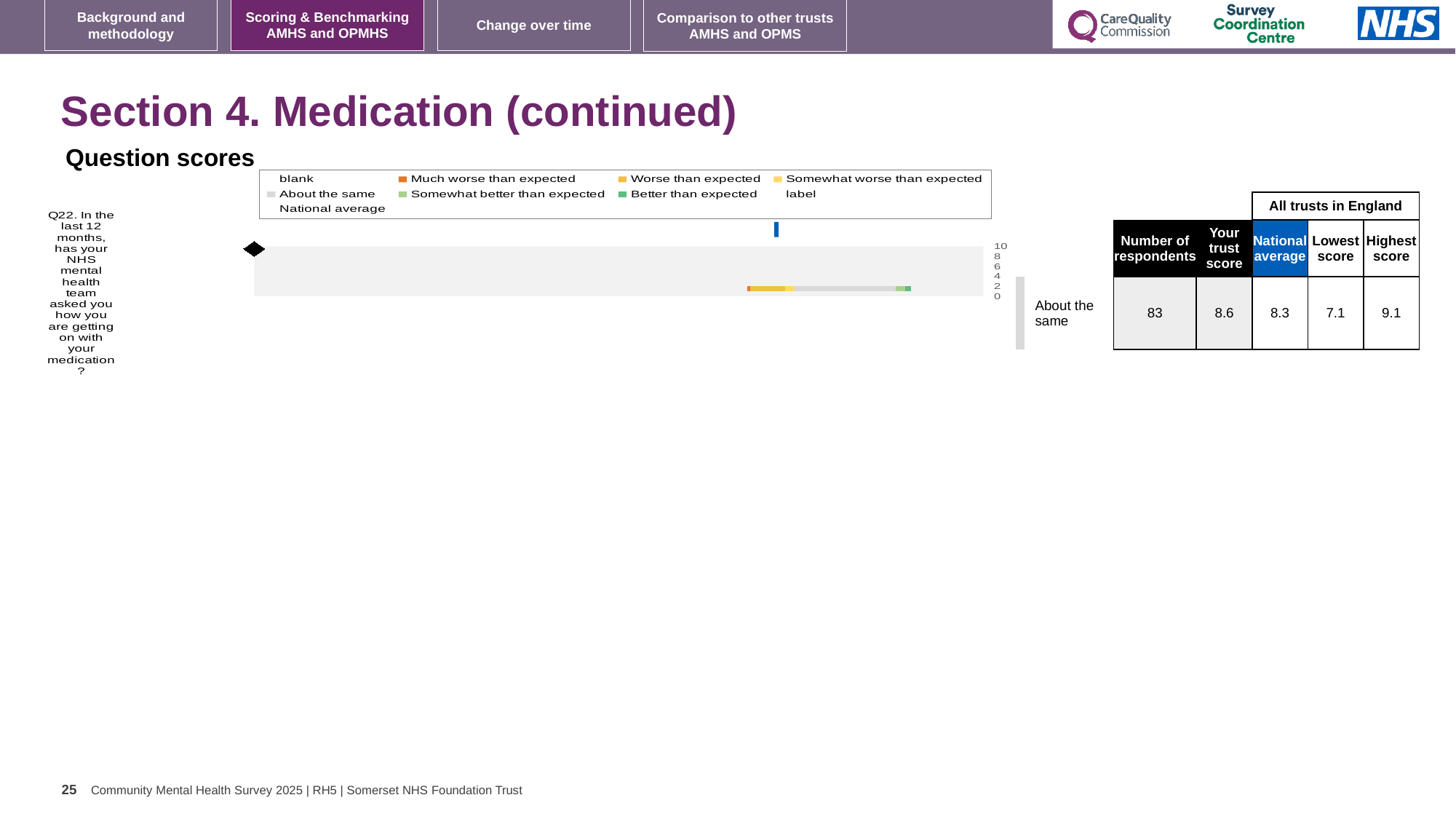
Which question number is plotted in the question scores chart? Q22 Is your trust score for Q22 higher or lower than the national average? Higher In the table beside the chart, what is the national average for Q22? 8.3 How many entries does the legend of the question scores chart list? 9 What is the highest tick value shown on the axis of the question scores chart? 10 What benchmark category label is shown next to the chart for Q22? About the same What is the difference between the highest score and the lowest score for Q22 in the table? 2.0 What kind of chart is shown under 'Question scores'? Bar chart In the table beside the chart, what is your trust score for Q22? 8.6 In the table beside the chart, what is the number of respondents for Q22? 83 In the table beside the chart, what is the highest score among all trusts in England for Q22? 9.1 How many questions (categories) are plotted in the question scores chart? 1